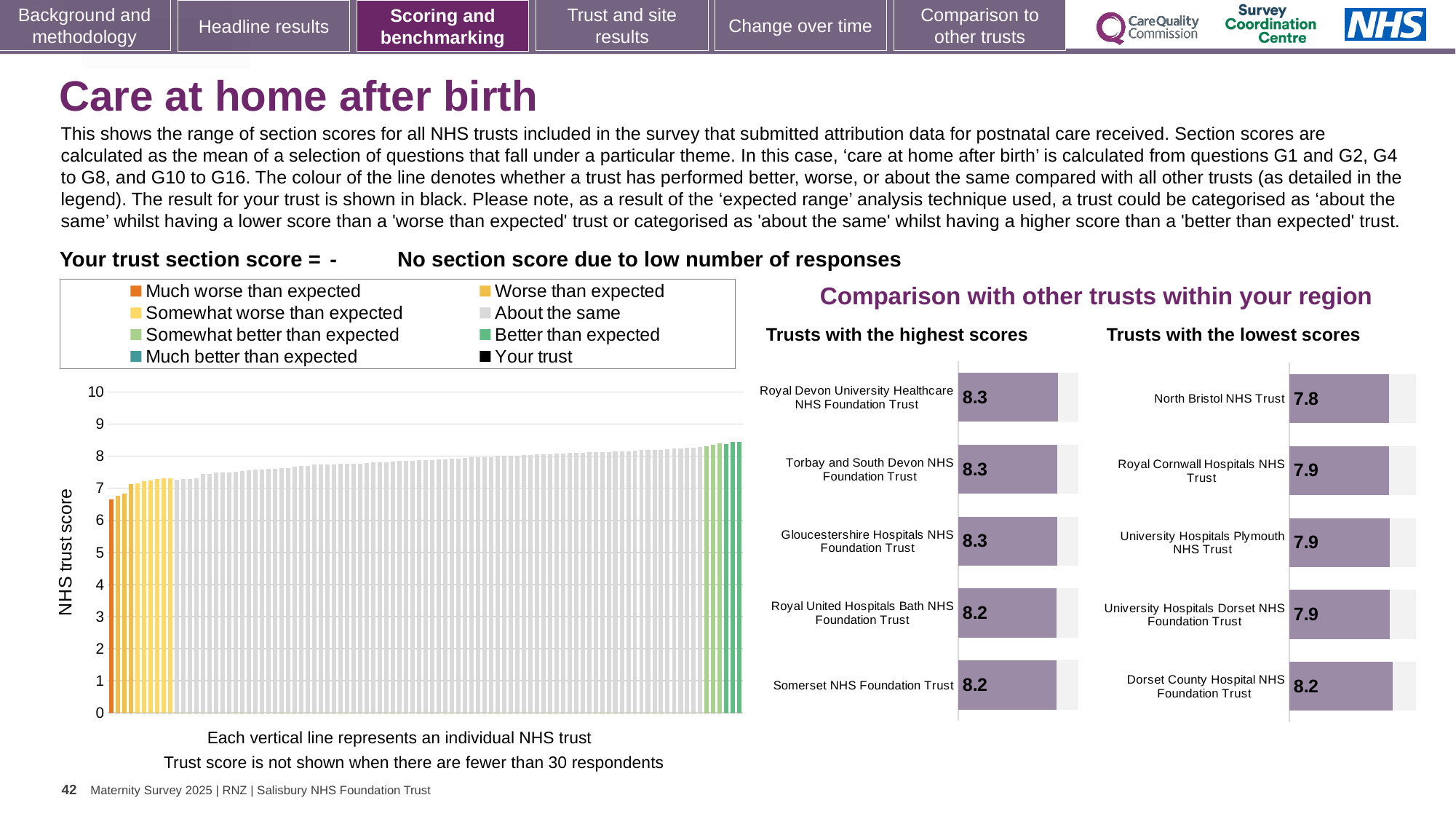
In the 'Trusts with the lowest scores' chart, which trust has the highest score? Dorset County Hospital NHS Foundation Trust In the 'Trusts with the highest scores' chart, what is the score for Somerset NHS Foundation Trust? 8.2 In the 'Trusts with the highest scores' chart, what is the score for Royal Devon University Healthcare NHS Foundation Trust? 8.3 How many entries does the legend of the large 'NHS trust score' chart list? 8 In the large 'NHS trust score' chart, is the value of the leftmost bar greater or less than 7? less In the 'Trusts with the highest scores' chart, which has the higher score: Royal United Hospitals Bath NHS Foundation Trust or Gloucestershire Hospitals NHS Foundation Trust? Gloucestershire Hospitals NHS Foundation Trust In the 'Trusts with the lowest scores' chart, what is the score for North Bristol NHS Trust? 7.8 In the 'Trusts with the lowest scores' chart, what is the difference between the scores of Dorset County Hospital NHS Foundation Trust and North Bristol NHS Trust? 0.4 What type of chart is the large 'NHS trust score' chart on the left? Bar chart In the large 'NHS trust score' chart, do the bar values rise or fall from left to right? Rise How many trusts are listed in the 'Trusts with the highest scores' chart? 5 In the 'Trusts with the lowest scores' chart, which trust has the lowest score? North Bristol NHS Trust